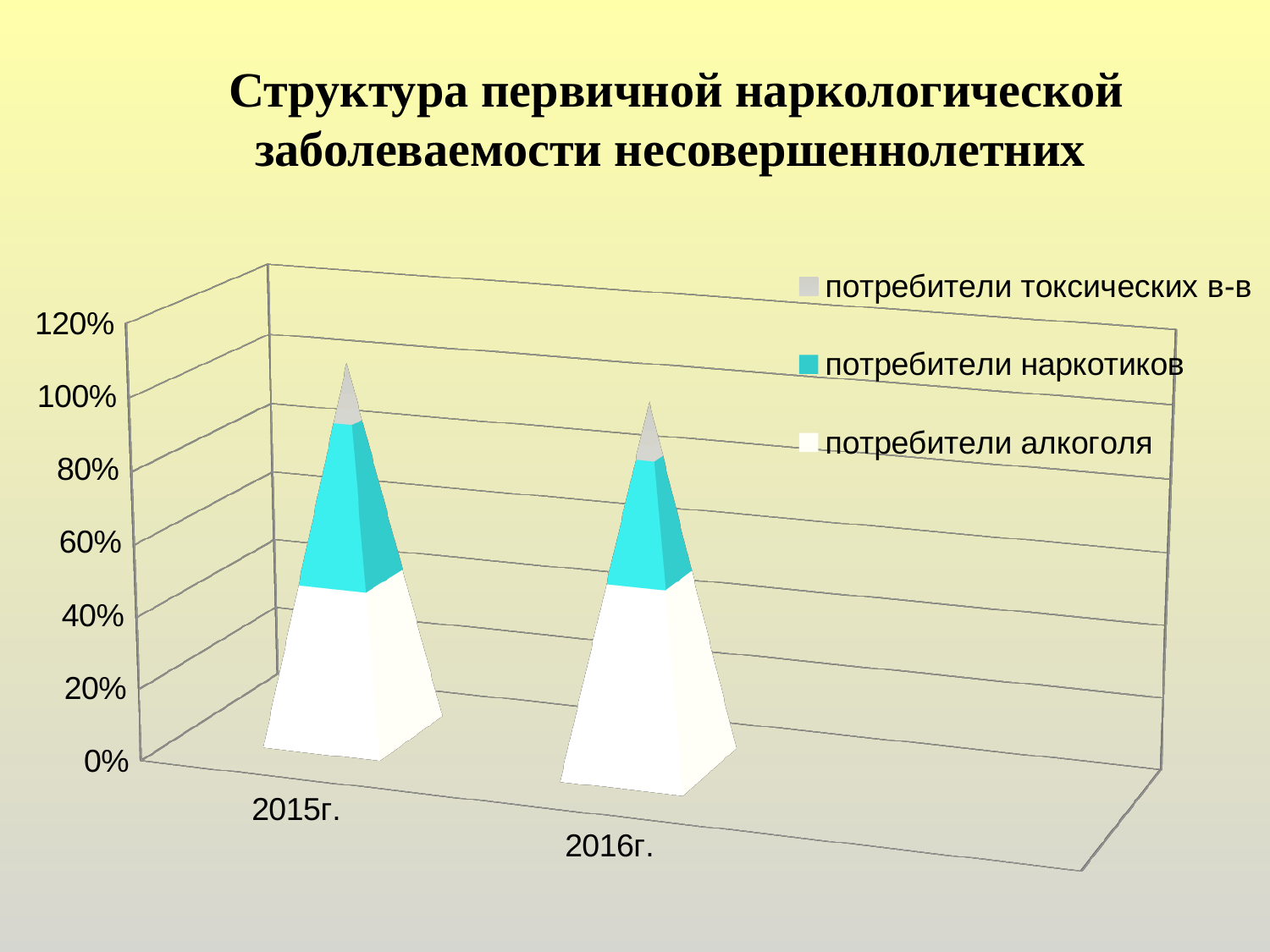
How many series does the chart's legend list? 3 Which year has the taller stacked bar in the chart, 2015г. or 2016г.? 2015г. Is the total stacked value for 2016г. greater or less than 20%? greater What is the title of the chart on the slide? Структура первичной наркологической заболеваемости несовершеннолетних How many categories (years) are shown on the x axis of the chart? 2 Which category has the lowest total stacked bar in the chart? 2016г. Does the total stacked bar height fall or rise from 2015г. to 2016г.? fall Which category has the highest total stacked bar in the chart? 2015г. What kind of chart is shown on the slide? bar chart Which series is shown in the turquoise colour in the chart? потребители наркотиков What is the highest value shown on the vertical axis of the chart? 120%